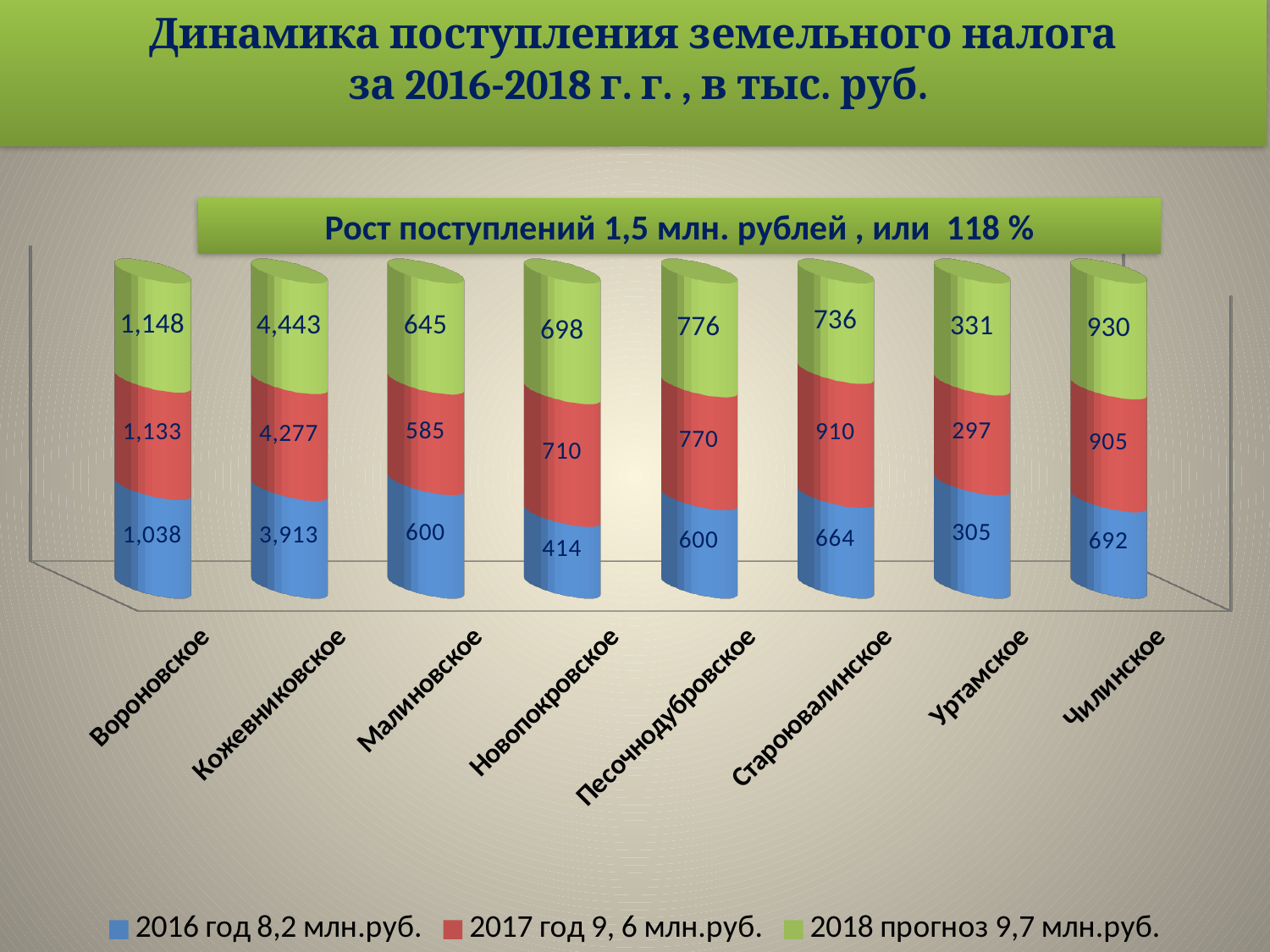
Which category has the lowest 2018 forecast value? Уртамское What is the 2016 value for Вороновское? 1,038 Which is larger, the 2017 value for Песочнодубровское or the 2017 value for Староювалинское? Староювалинское Which category has the highest 2016 value? Кожевниковское How many series does the legend list? 3 What is the total of the three values for Уртамское? 933 What is the 2018 forecast value for Чилинское? 930 What is the difference between the 2018 forecast and the 2016 value for Кожевниковское? 530 What is the 2018 forecast value for Кожевниковское? 4,443 How many categories are shown on the x axis? 8 What kind of chart is shown on the slide? Stacked bar chart What is the 2017 value for Новопокровское? 710